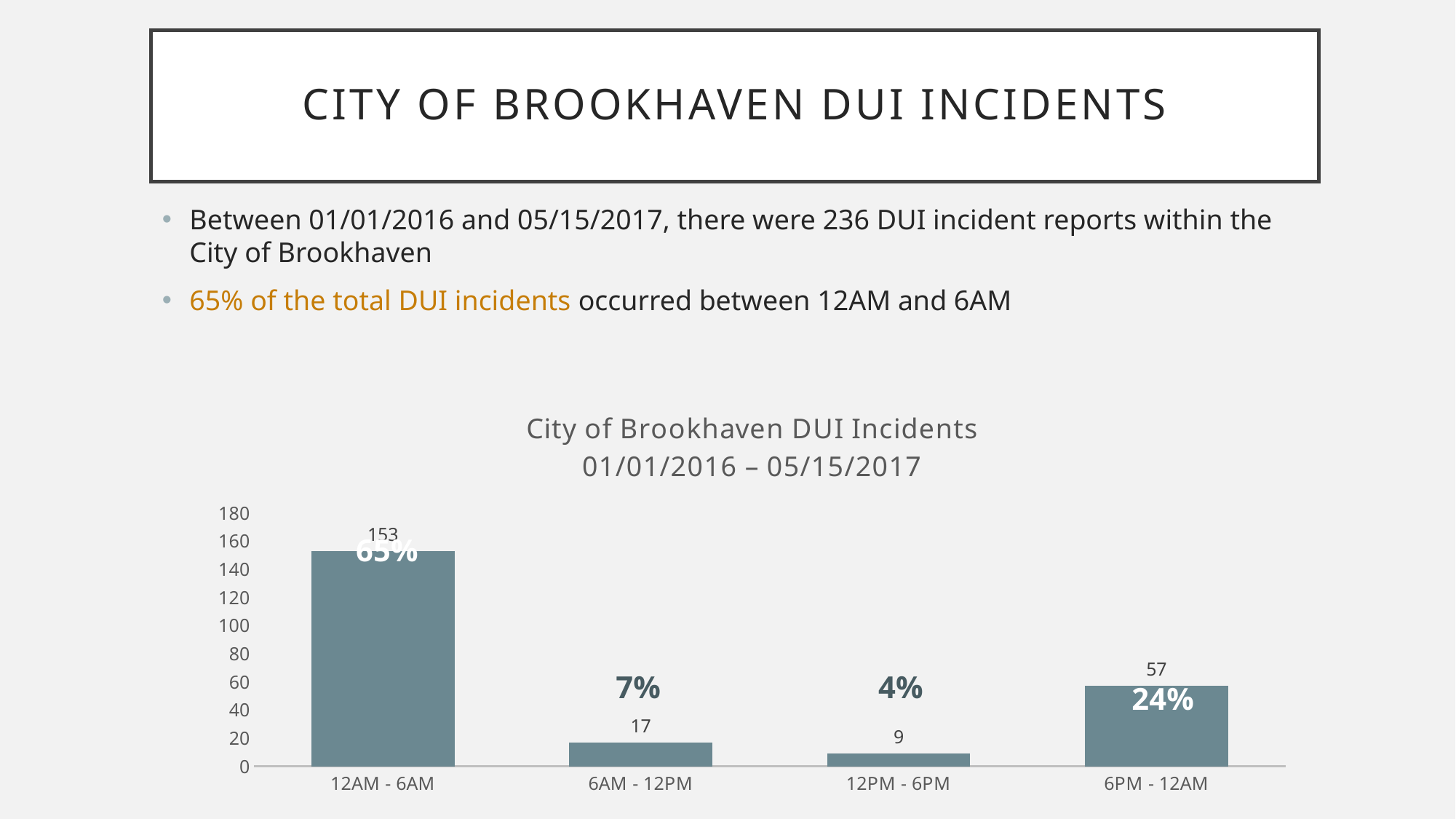
What is the difference in DUI incidents between the 12AM - 6AM and 6PM - 12AM periods? 96 What is the number of DUI incidents for the 12AM - 6AM period? 153 What is the number of DUI incidents for the 6PM - 12AM period? 57 Which time period has the lowest number of DUI incidents? 12PM - 6PM What is the title of the chart? City of Brookhaven DUI Incidents 01/01/2016 – 05/15/2017 Which has more DUI incidents, 6AM - 12PM or 12PM - 6PM? 6AM - 12PM Which time period has the highest number of DUI incidents? 12AM - 6AM What percentage label is shown on the 6AM - 12PM bar? 7% Is the value for 6PM - 12AM greater or less than 40? greater How many time periods are shown on the chart? 4 What type of chart is shown on the slide? Bar chart What is the number of DUI incidents for the 12PM - 6PM period? 9